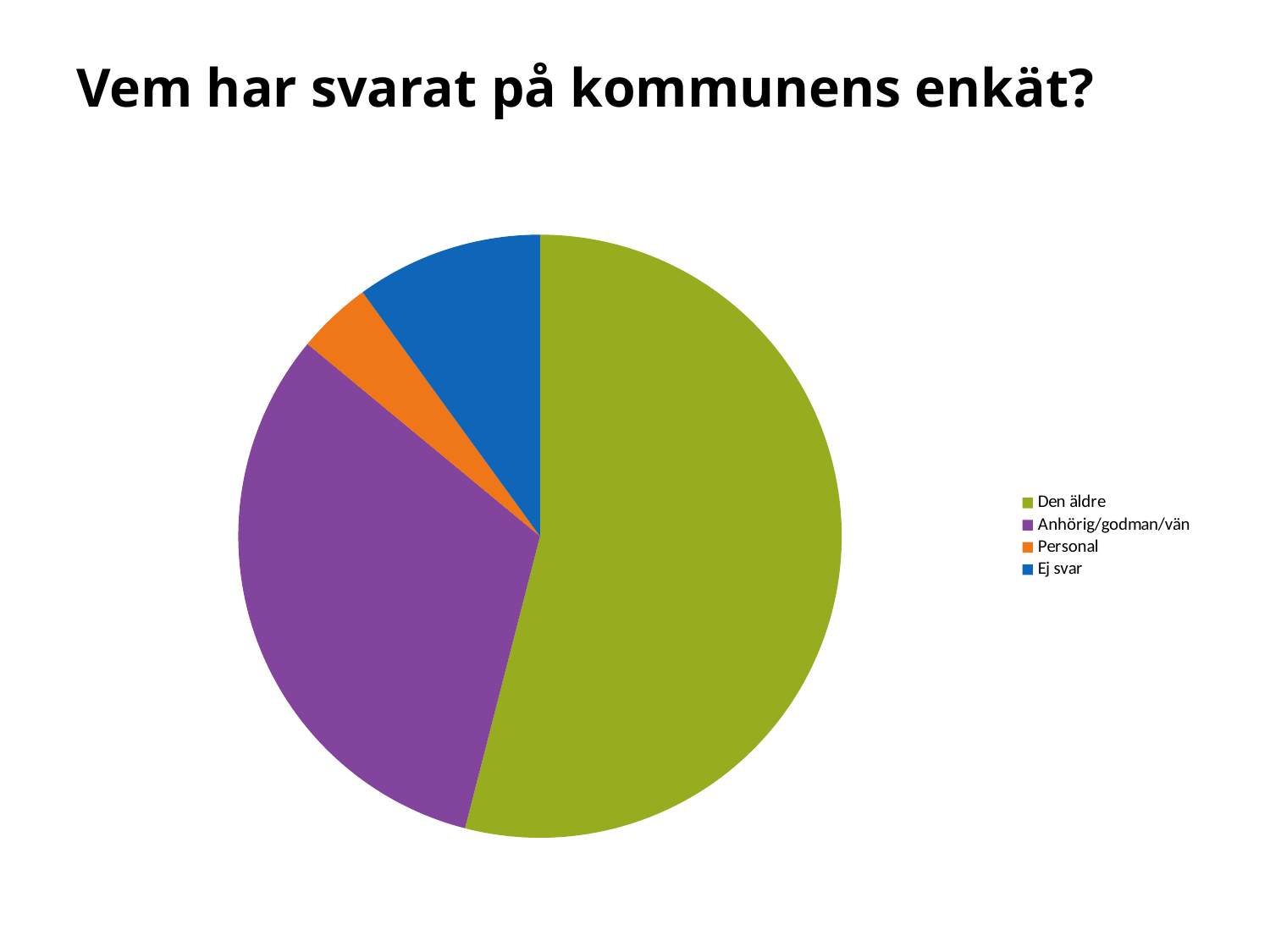
How many entries does the legend list? 4 Which slice is larger, Den äldre or Anhörig/godman/vän? Den äldre Which category is the second largest slice of the pie? Anhörig/godman/vän Which category has the largest slice of the pie? Den äldre How many slices does the pie chart have? 4 Which slice is larger, Ej svar or Personal? Ej svar What is the title of the chart on the slide? Vem har svarat på kommunens enkät? Does the Den äldre slice take up more or less than half of the pie? more Which category has the smallest slice of the pie? Personal What kind of chart is shown on the slide? Pie chart What colour is the Personal slice in the pie chart? Orange